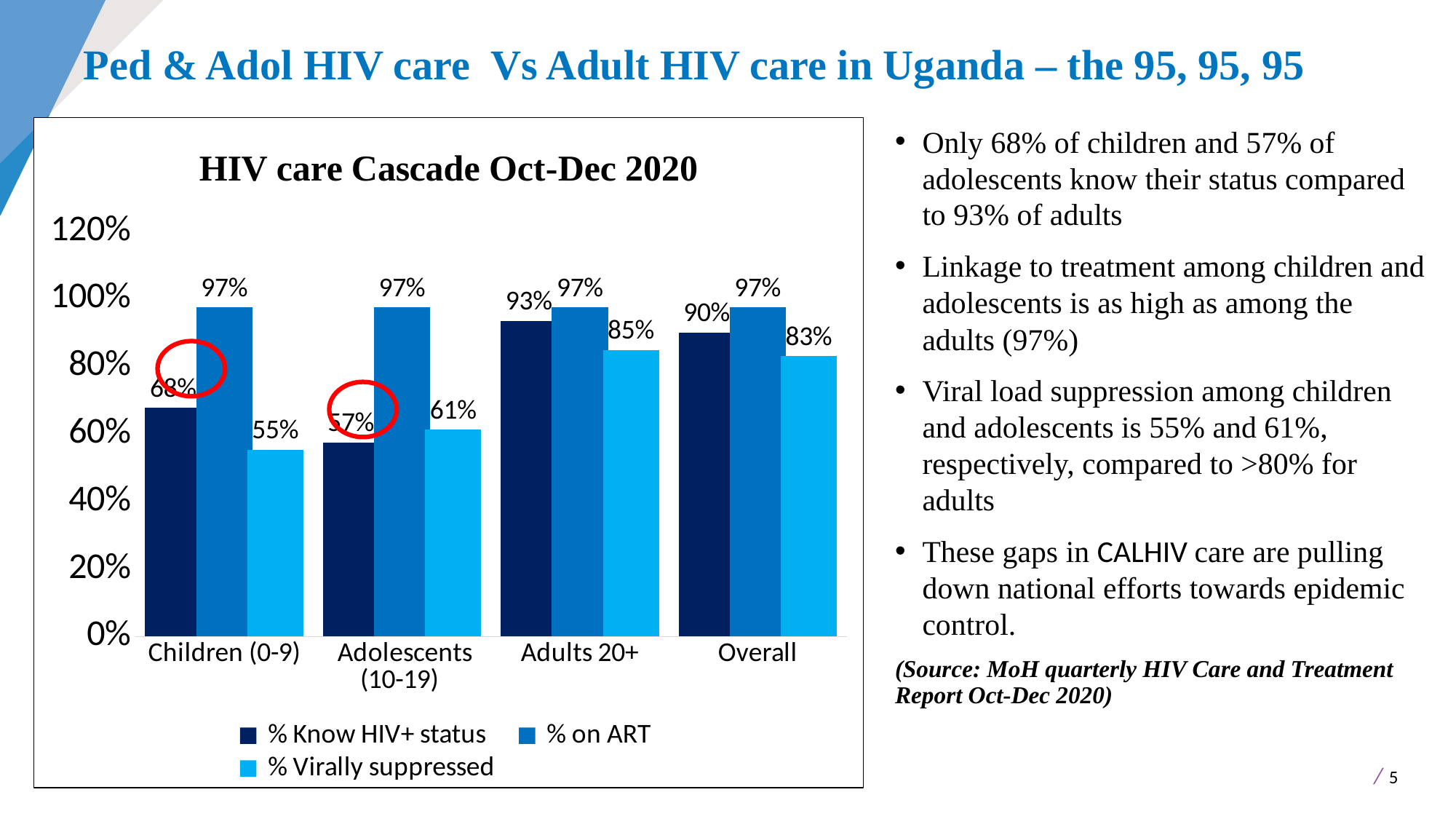
How many categories are shown on the x axis of the chart? 4 Which is larger, the % Virally suppressed value for Adolescents (10-19) or for Children (0-9)? Adolescents (10-19) Which category has the highest % Virally suppressed value? Adults 20+ What is the difference between the % Know HIV+ status values for Adults 20+ and Children (0-9)? 25% Which category has the lowest % Know HIV+ status value? Adolescents (10-19) How many series does the chart legend list? 3 What is the % Know HIV+ status value for Adolescents (10-19)? 57% What is the % on ART value for Adults 20+? 97% What is the title of the chart? HIV care Cascade Oct-Dec 2020 What is the % Virally suppressed value for Children (0-9)? 55% What is the % Virally suppressed value for Overall? 83% What type of chart is shown on the slide? Bar chart